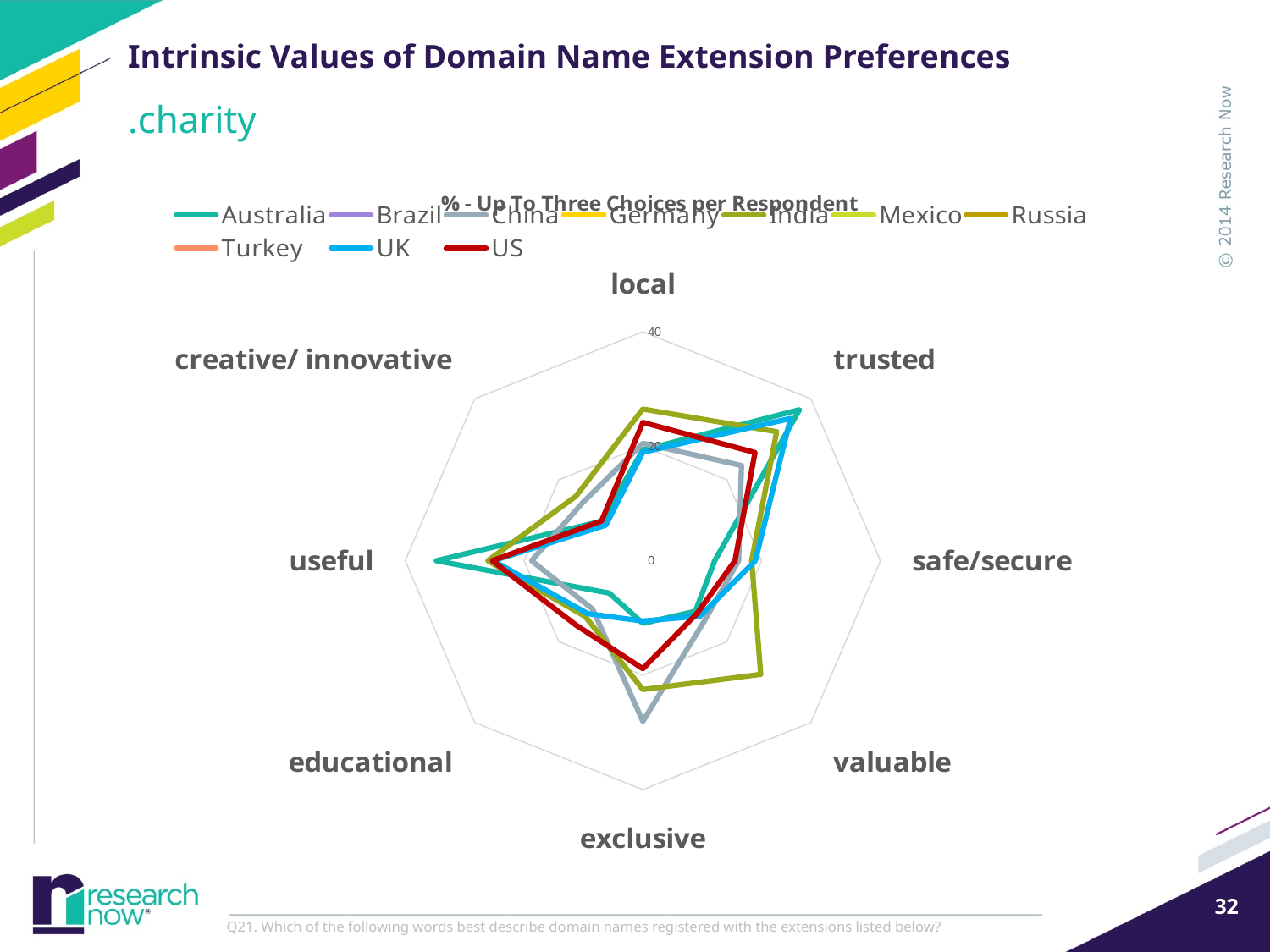
Is the value for China on 'exclusive' greater or less than 20? greater How many categories (axes) does the radar chart have? 8 What is the title of the chart? % - Up To Three Choices per Respondent Is the value for Australia on 'useful' greater or less than 20? greater How many series does the legend list? 10 Which series reaches the highest value on the 'exclusive' axis? China What is the highest value shown on the chart's axis scale? 40 Which series reaches the highest value on the 'useful' axis? Australia Is the value for UK on 'trusted' greater or less than 20? greater What kind of chart is shown on the slide? radar chart